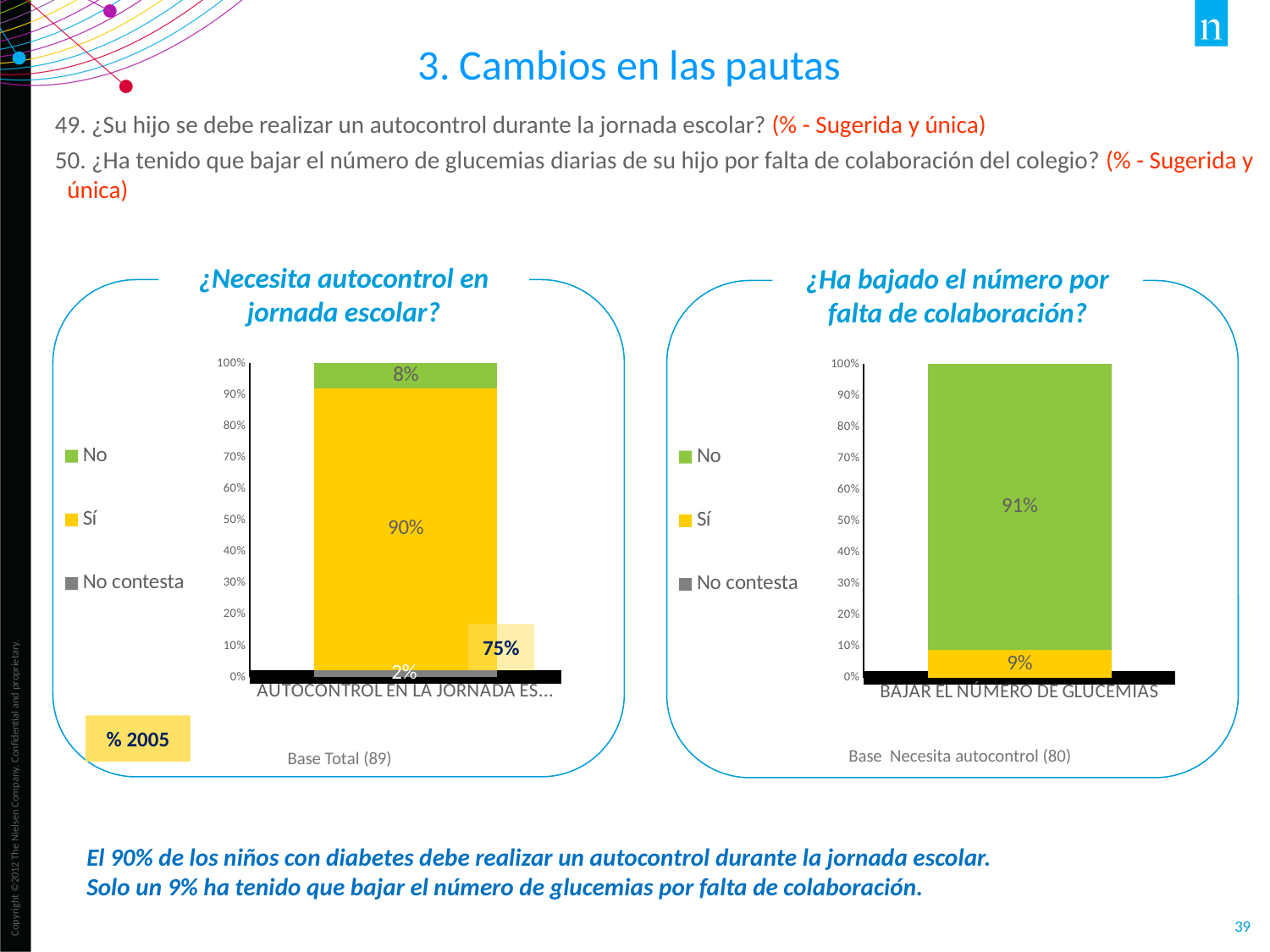
In the chart '¿Ha bajado el número por falta de colaboración?', what percentage is shown for 'No'? 91% In the chart '¿Necesita autocontrol en jornada escolar?', which response has the smallest share? No contesta In the chart '¿Necesita autocontrol en jornada escolar?', which response has the largest share? Sí How many series does the legend list in the chart '¿Ha bajado el número por falta de colaboración?'? 3 In the chart '¿Ha bajado el número por falta de colaboración?', what is the difference between the 'No' and 'Sí' percentages? 82% What type of chart is '¿Necesita autocontrol en jornada escolar?'? Stacked bar chart In the chart '¿Ha bajado el número por falta de colaboración?', what percentage is shown for 'Sí'? 9% In the chart '¿Necesita autocontrol en jornada escolar?', what percentage is shown for 'No contesta'? 2% In the chart '¿Necesita autocontrol en jornada escolar?', what percentage is shown for 'No'? 8% In the chart '¿Necesita autocontrol en jornada escolar?', what is the difference between the 'Sí' and 'No' percentages? 82% In the chart '¿Ha bajado el número por falta de colaboración?', which response has the largest share? No In the chart '¿Necesita autocontrol en jornada escolar?', what percentage is shown for 'Sí'? 90%